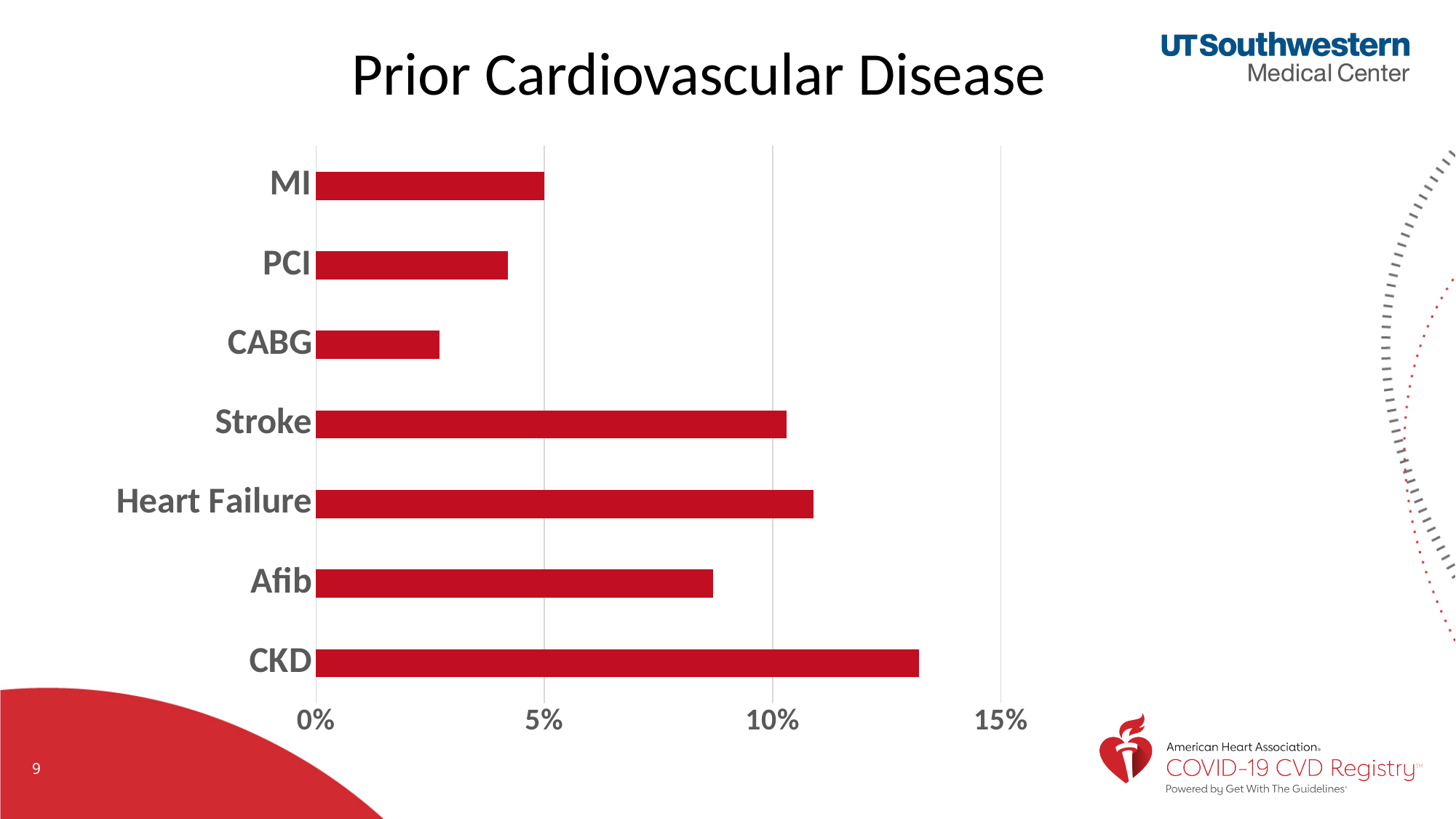
Which is larger, the value for PCI or the value for CABG? PCI What kind of chart is shown on the slide? bar chart Which category has the lowest value? CABG Which is larger, the value for Stroke or the value for Afib? Stroke Is the value for CKD greater or less than 15%? less Is the value for CKD greater or less than 10%? greater How many categories are plotted in the chart? 7 Which category has the highest value? CKD Is the value for CABG greater or less than 5%? less What is the title of the chart? Prior Cardiovascular Disease